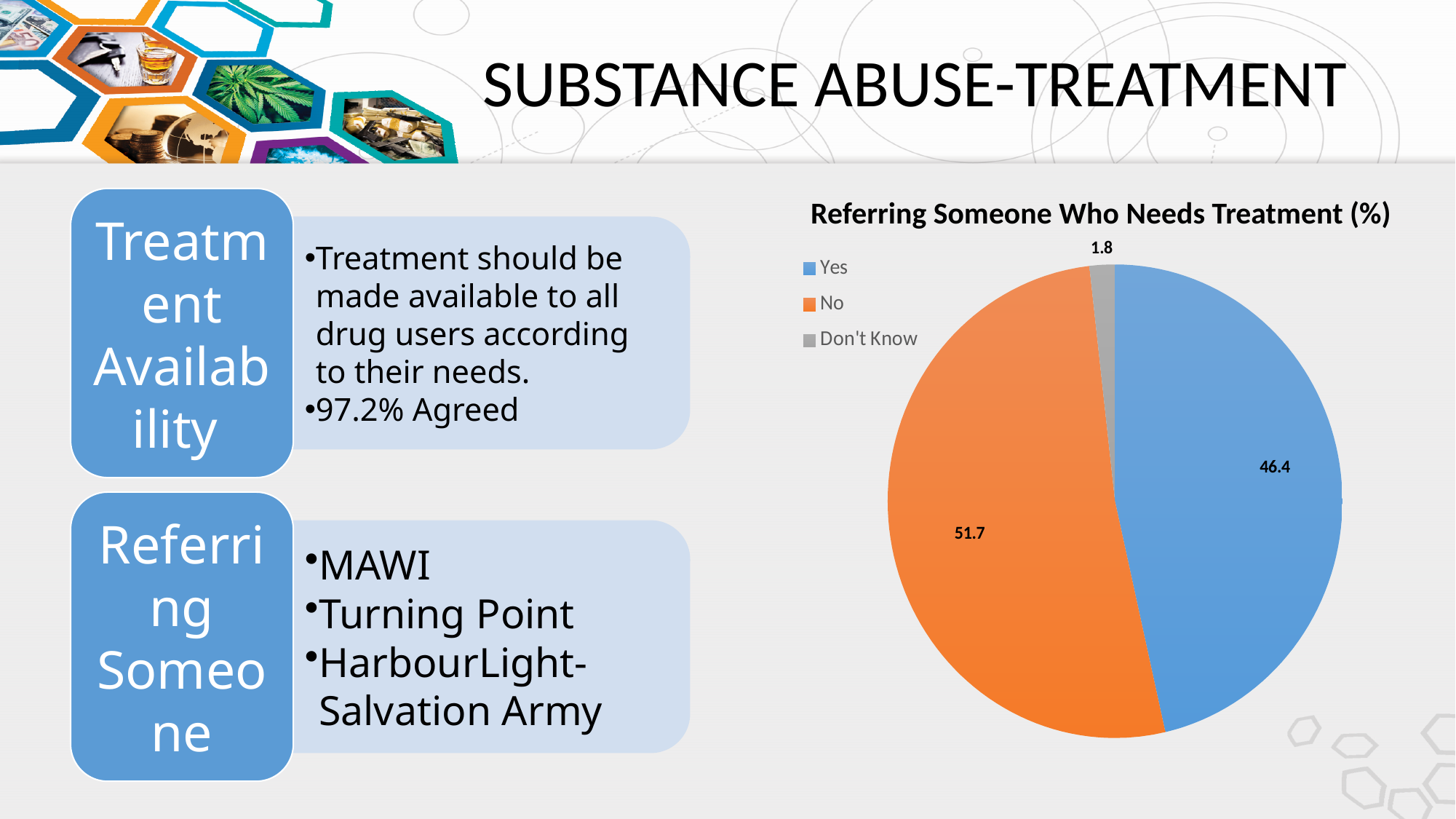
What is the title of the chart? Referring Someone Who Needs Treatment (%) Which category has the smallest slice of the pie? Don't Know What is the value for No in the pie chart? 51.7 Which is larger, the value for Yes or the value for No? No What is the difference between the No and Yes values? 5.3 Which category has the largest slice of the pie? No How many categories does the pie chart show? 3 How many entries does the legend list? 3 What is the value for Don't Know in the pie chart? 1.8 What colour is the slice for Don't Know? grey What type of chart is shown on the slide? pie chart What is the value for Yes in the pie chart? 46.4